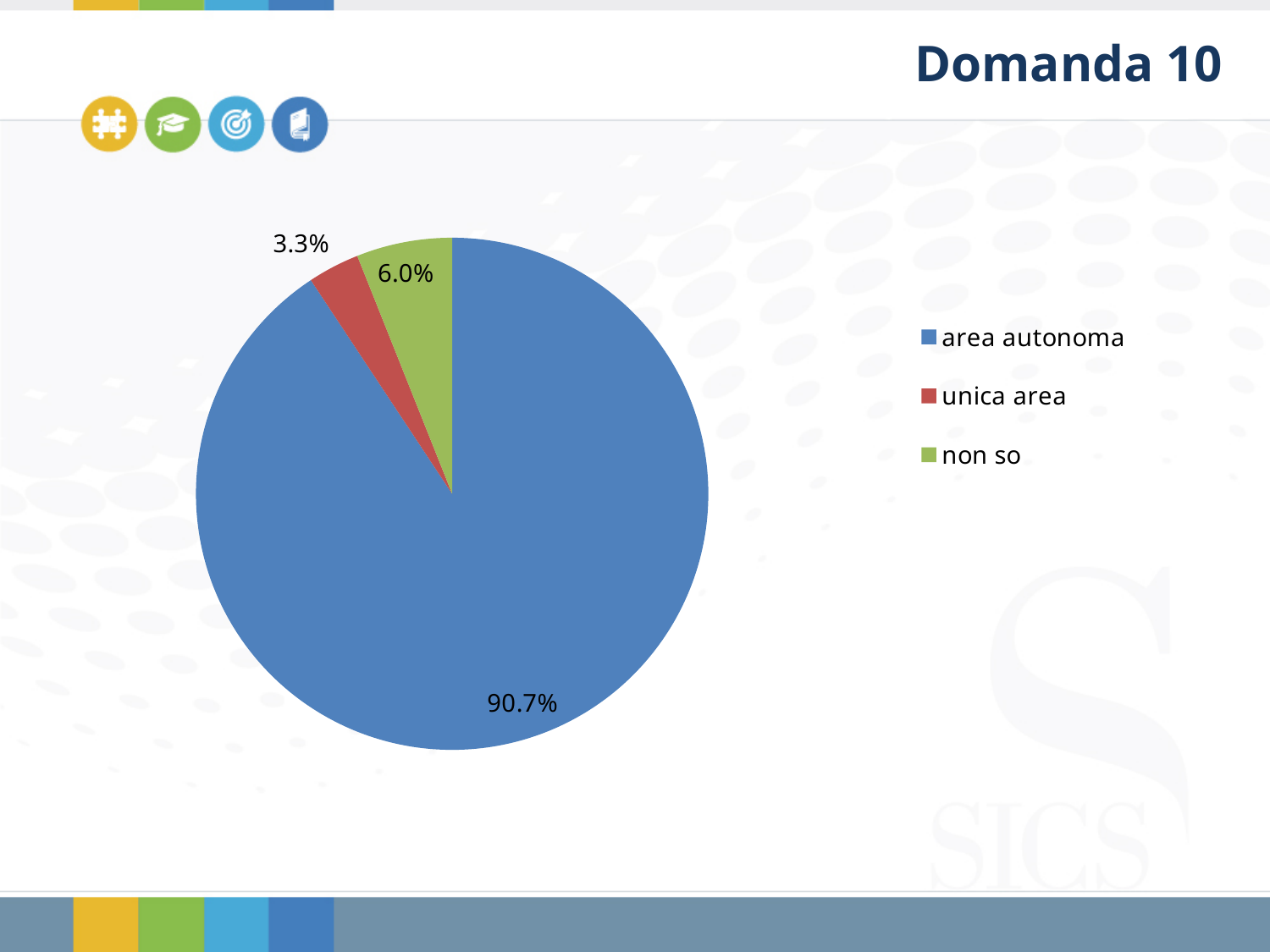
Which category has the smallest share of the pie? unica area What percentage of the pie is labelled "unica area"? 3.3% What is the title of the slide containing the chart? Domanda 10 How many categories does the pie chart show? 3 What colour is the slice for "unica area"? red What type of chart is shown on the slide? pie chart What percentage of the pie is labelled "area autonoma"? 90.7% Which is larger, the share for "non so" or the share for "unica area"? non so What is the difference in percentage points between "area autonoma" and "non so"? 84.7 What is the difference in percentage points between "non so" and "unica area"? 2.7 Which category has the largest share of the pie? area autonoma What percentage of the pie is labelled "non so"? 6.0%